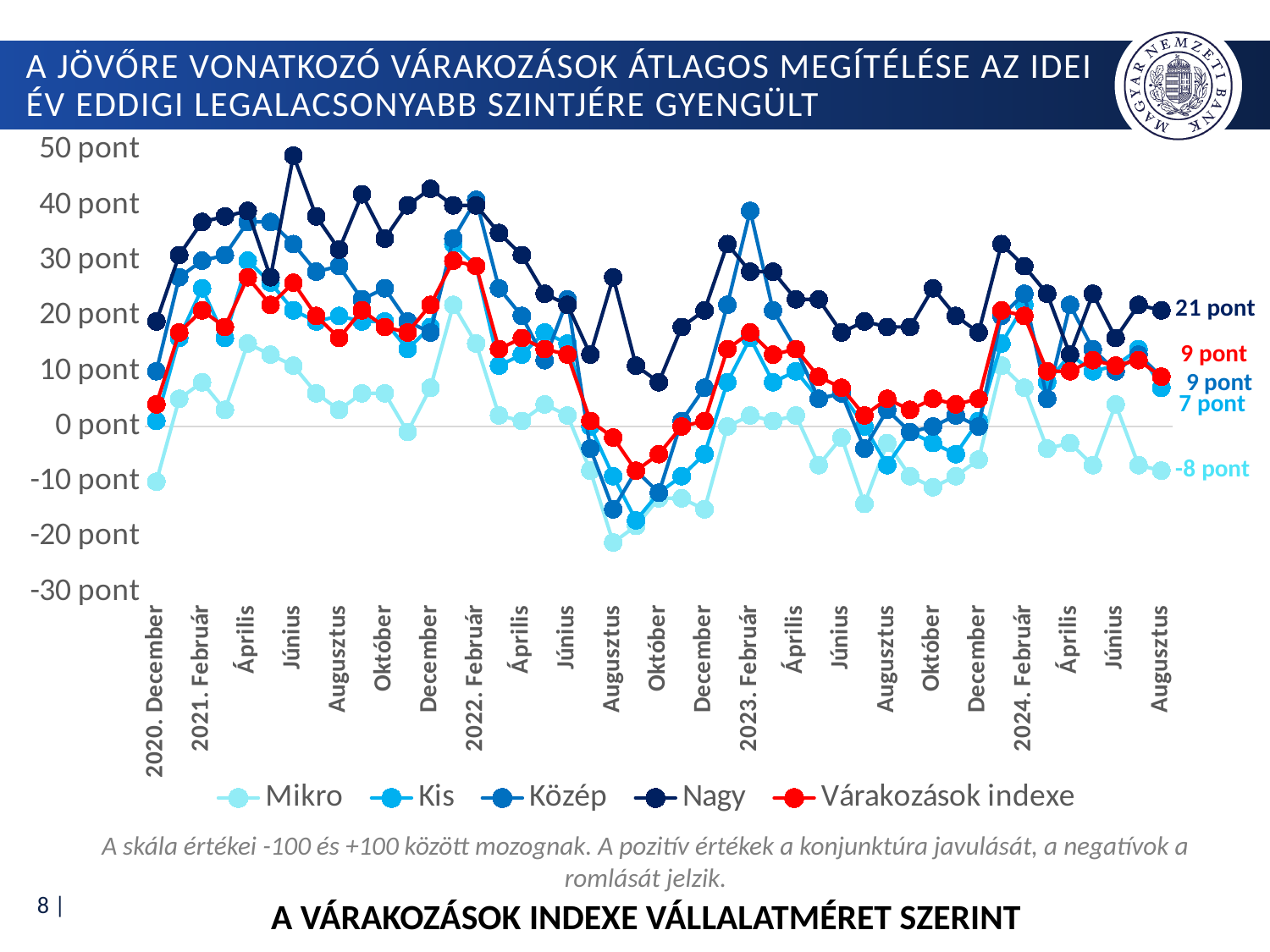
What is the value of the Mikro series at 2024 Augusztus? -8 pont What kind of chart is shown on the slide? line chart What is the value of the Kis series at 2024 Augusztus? 7 pont Is the value for Nagy in 2021 Június greater or less than 40 pont? greater At 2024 Augusztus, which is larger: the Nagy value or the Mikro value? Nagy What is the difference between the Nagy and Mikro values at 2024 Augusztus? 29 pont What is the value of the Nagy series at 2024 Augusztus? 21 pont Is the value for Mikro in 2022 Augusztus greater or less than -10 pont? less What is the value of the Várakozások indexe series at 2024 Augusztus? 9 pont Which series has the highest value at 2024 Augusztus? Nagy How many series does the legend list? 5 Which series has the lowest value at 2024 Augusztus? Mikro